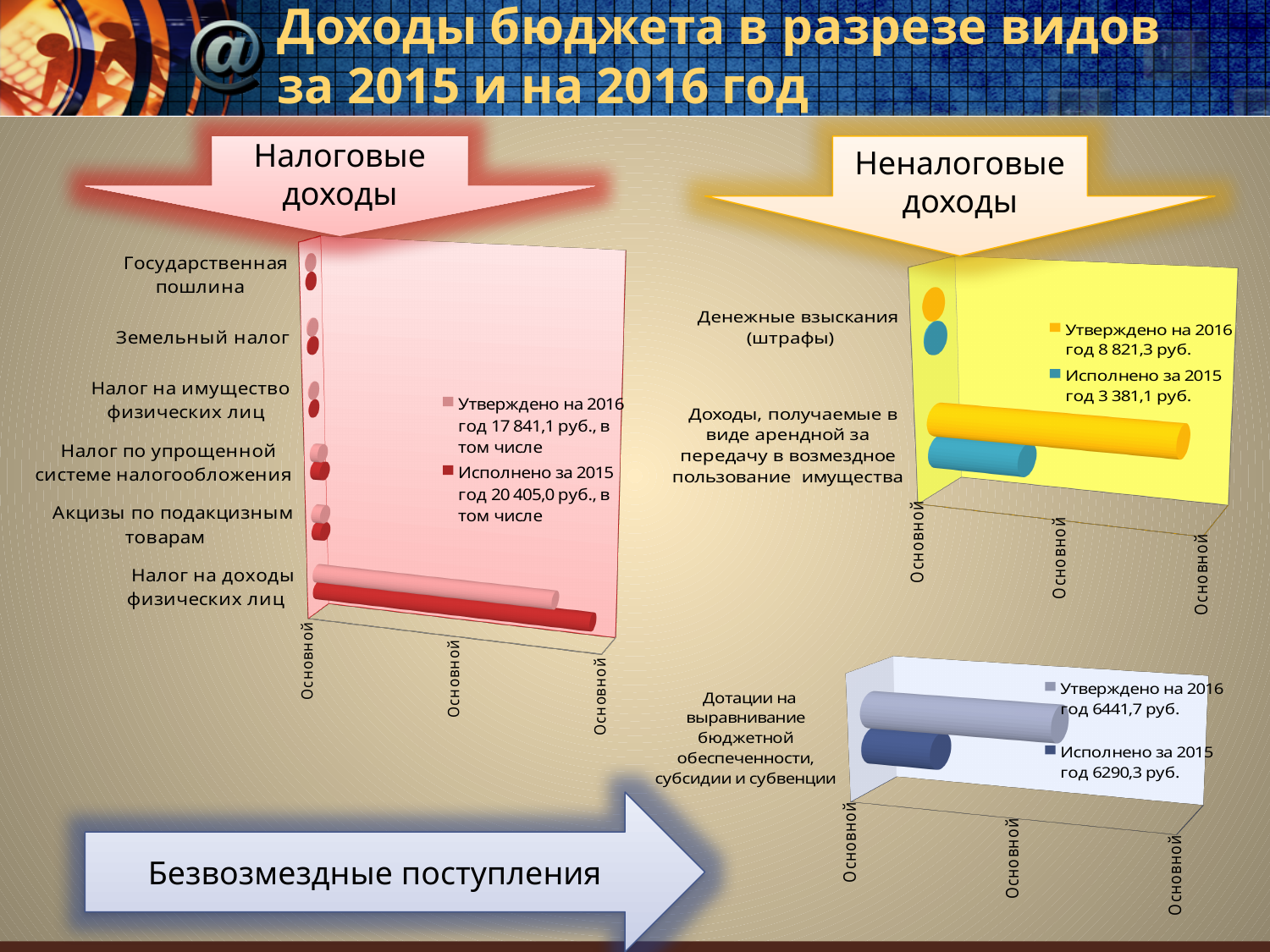
According to the legend of the 'Безвозмездные поступления' chart, what total is given for 'Утверждено на 2016 год'? 6441,7 руб. In the 'Неналоговые доходы' chart, which category has the higher values? Доходы, получаемые в виде арендной за передачу в возмездное пользование имущества According to the legend of the 'Неналоговые доходы' chart, what total is given for 'Исполнено за 2015 год'? 3 381,1 руб. How many series does the legend of the 'Налоговые доходы' chart list? 2 In the 'Безвозмездные поступления' chart, which series has the larger bar: 'Утверждено на 2016 год' or 'Исполнено за 2015 год'? Утверждено на 2016 год In the 'Налоговые доходы' chart, for 'Налог на доходы физических лиц', which series has the larger bar: 'Утверждено на 2016 год' or 'Исполнено за 2015 год'? Исполнено за 2015 год How many categories are shown in the 'Безвозмездные поступления' chart at the bottom right? 1 In the 'Налоговые доходы' chart, which category has the highest values? Налог на доходы физических лиц In the 'Неналоговые доходы' chart, for rental income, which series has the larger bar: 'Утверждено на 2016 год' or 'Исполнено за 2015 год'? Утверждено на 2016 год What kind of chart is the 'Налоговые доходы' chart on the left? bar chart How many categories are shown in the 'Налоговые доходы' chart on the left? 6 How many categories are shown in the 'Неналоговые доходы' chart on the top right? 2